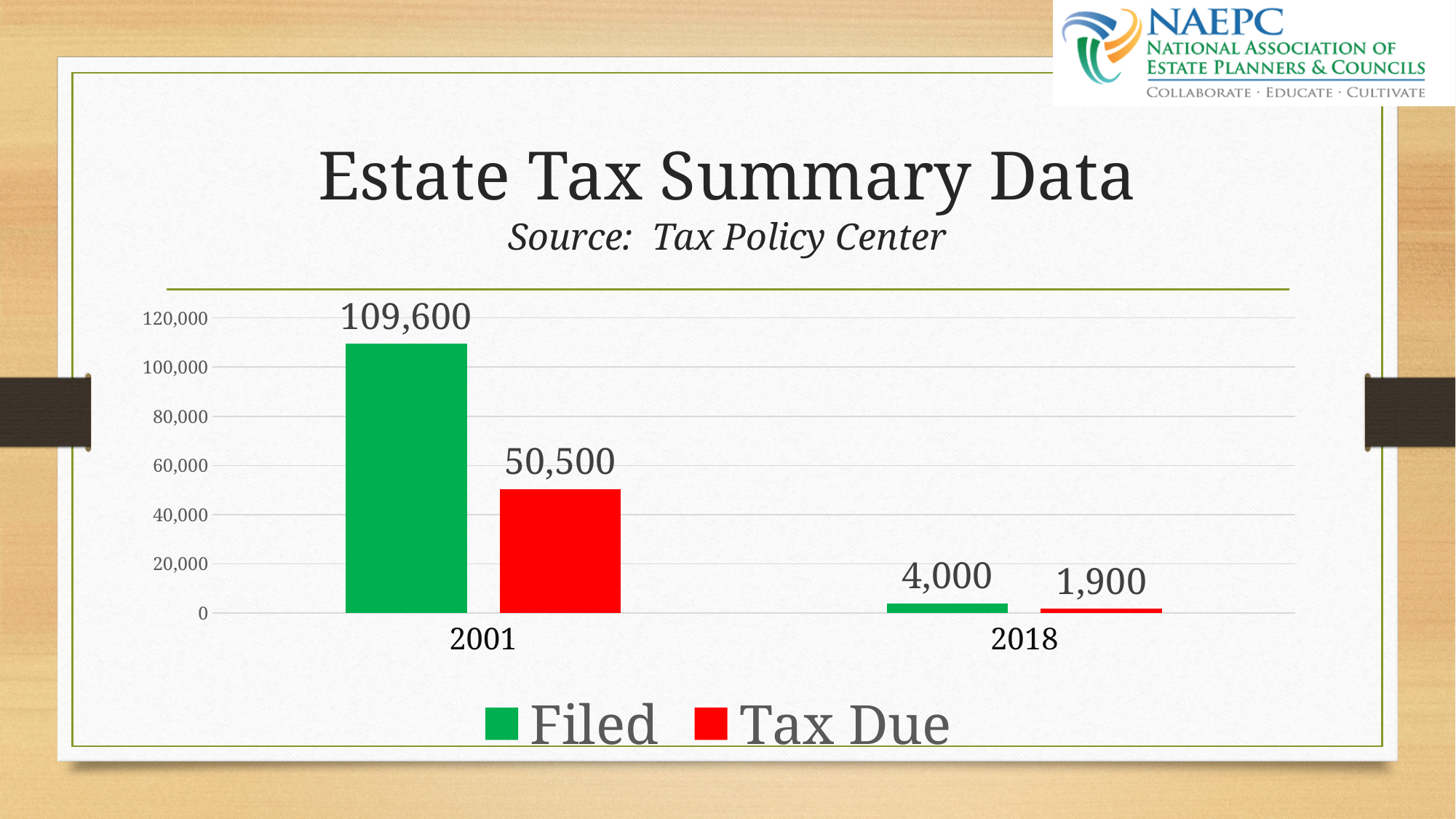
Which year has the highest Filed value? 2001 What is the value for Tax Due in 2001? 50,500 Which year has the lowest Tax Due value? 2018 What is the difference between Filed and Tax Due in 2001? 59,100 What is the difference between the Filed values for 2001 and 2018? 105,600 Do the Filed values rise or fall from 2001 to 2018? Fall What is the value for Filed in 2001? 109,600 What is the value for Filed in 2018? 4,000 What is the value for Tax Due in 2018? 1,900 Which is larger in 2018, Filed or Tax Due? Filed What kind of chart is shown on the slide? Bar chart How many series does the legend list? 2